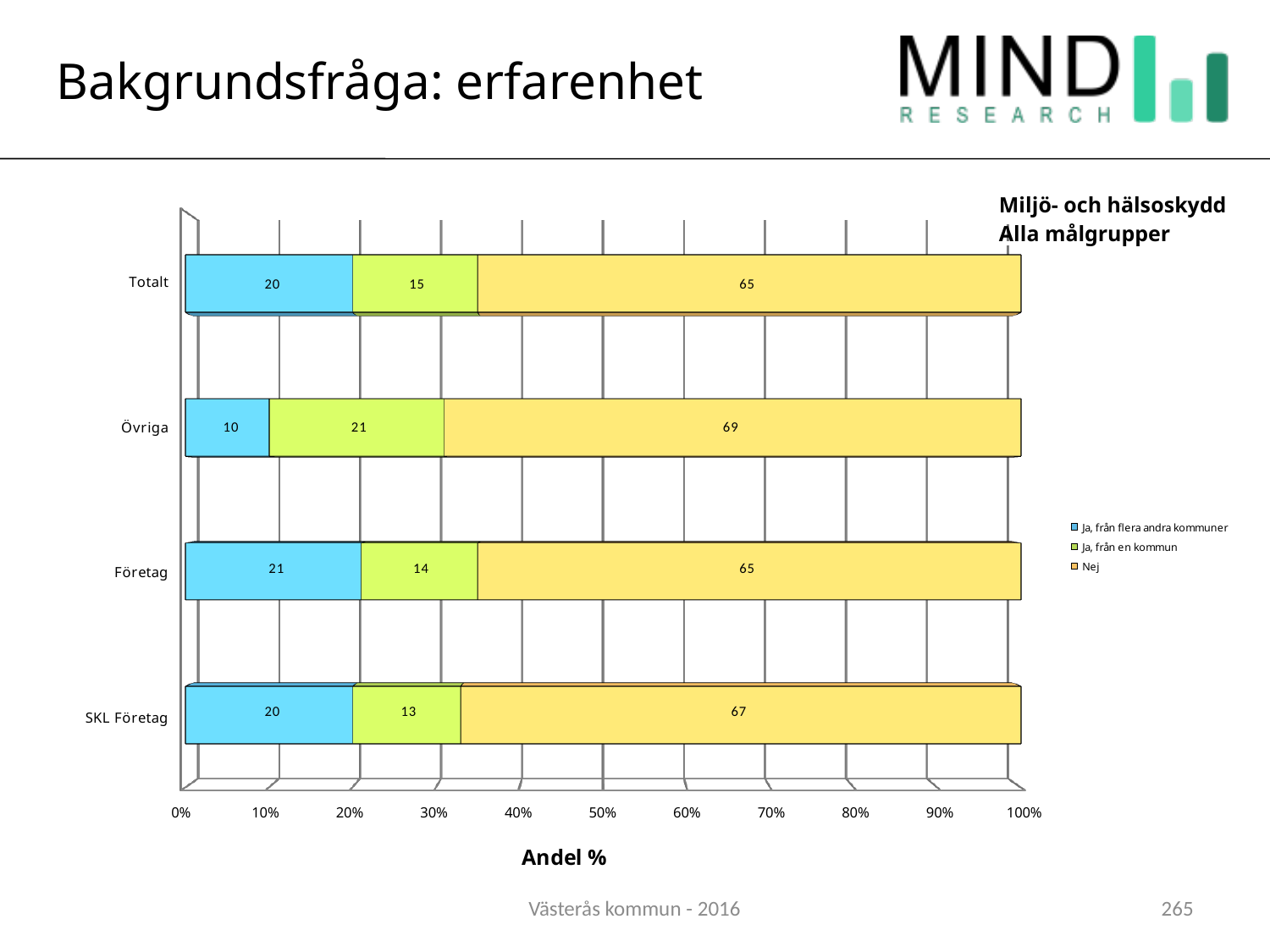
Which is larger: the 'Nej' value for SKL Företag or for Totalt? SKL Företag What is the total of the stacked bar for Totalt? 100 What is the value of 'Ja, från en kommun' for SKL Företag? 13 What is the value of 'Ja, från flera andra kommuner' for Företag? 21 What is the difference between the 'Ja, från en kommun' values for Övriga and Företag? 7 What is the label of the horizontal axis? Andel % How many series does the legend list? 3 Which category has the highest value for 'Nej'? Övriga What is the value of 'Nej' for Övriga? 69 What kind of chart is shown on the slide? Stacked bar chart How many categories are shown on the vertical axis of the chart? 4 Which category has the lowest value for 'Ja, från flera andra kommuner'? Övriga